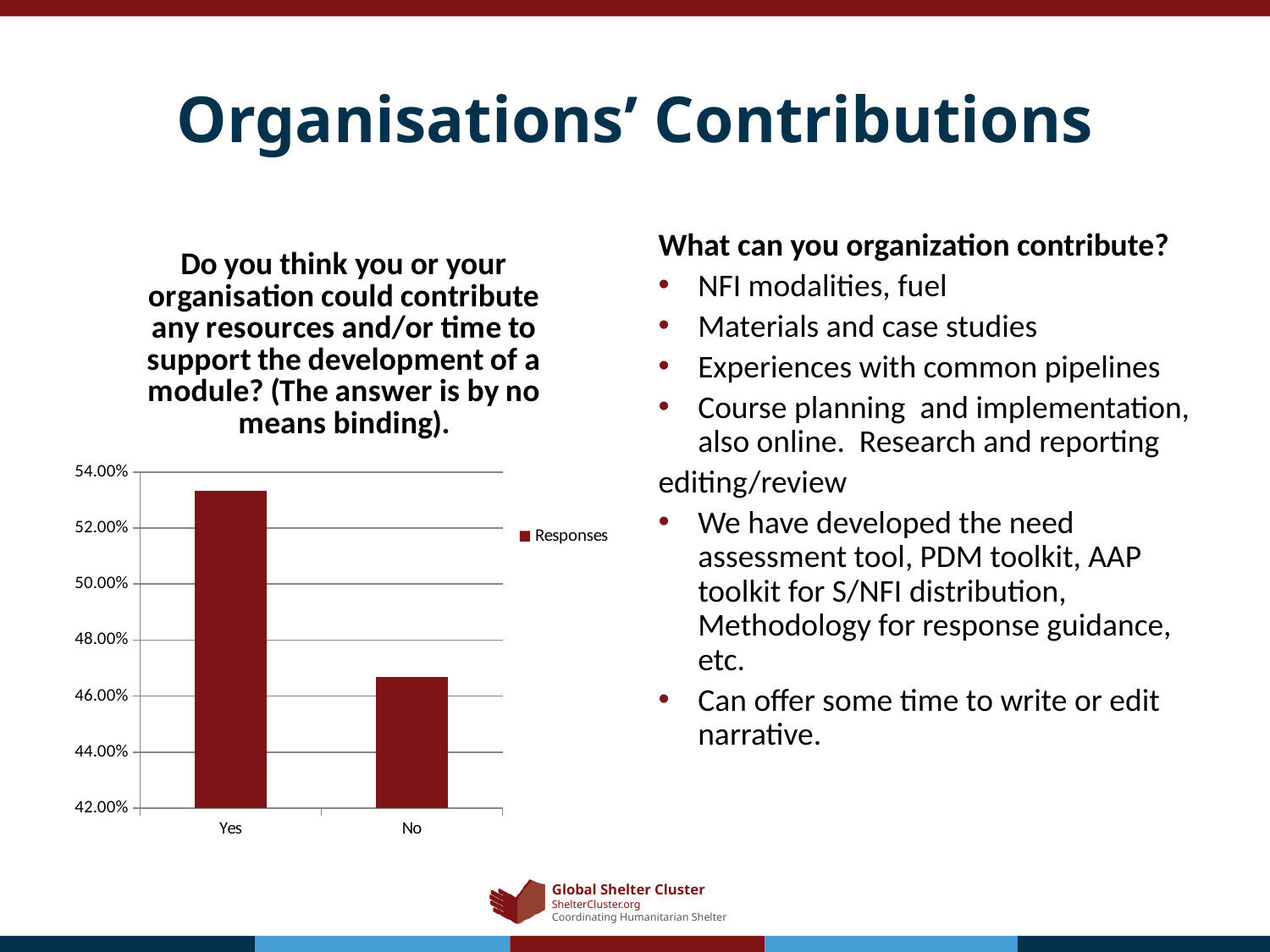
Which is larger, the value for Yes or the value for No? Yes How many categories are shown on the x axis of the chart? 2 What kind of chart is shown on the slide? bar chart Is the value for No greater or less than 46.00%? greater Is the value for Yes greater or less than 54.00%? less Which category has the lowest value in the chart? No How many series does the chart legend list? 1 What is the name of the series listed in the chart legend? Responses Which category has the highest value in the chart? Yes Is the value for Yes greater or less than 52.00%? greater What is the lowest value shown on the chart's vertical axis? 42.00%